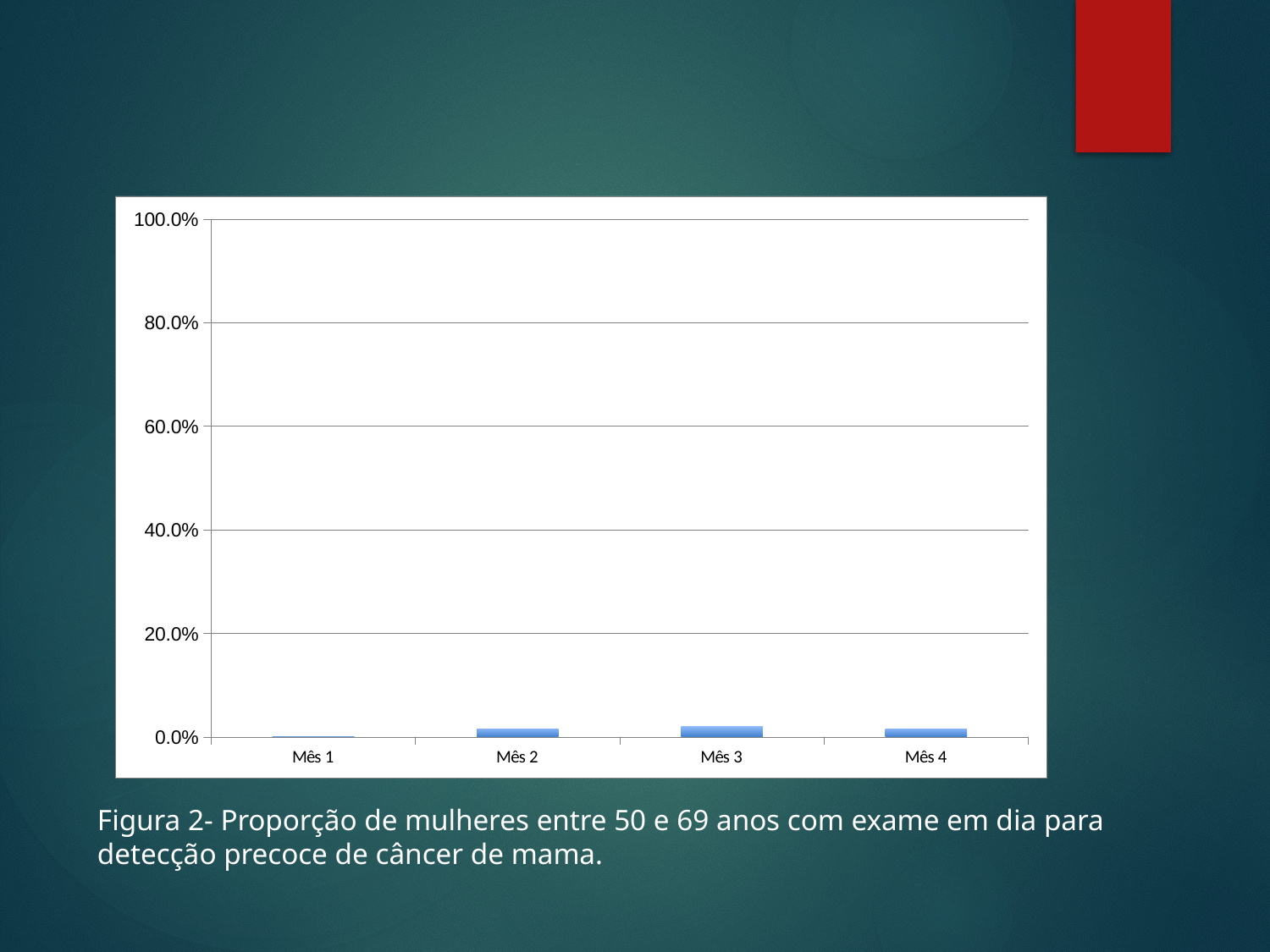
Which month has the highest bar in the chart? Mês 3 Is the value for Mês 2 greater or less than 20.0%? less Is the value for Mês 3 greater or less than 20.0%? less Which month has the lowest bar in the chart? Mês 1 Which is larger, the value for Mês 3 or the value for Mês 1? Mês 3 What is the figure caption below the chart? Figura 2- Proporção de mulheres entre 50 e 69 anos com exame em dia para detecção precoce de câncer de mama. What kind of chart is shown on the slide? bar chart How many categories are shown on the x axis of the chart? 4 Which is larger, the value for Mês 2 or the value for Mês 1? Mês 2 Is the value for Mês 4 greater or less than 40.0%? less What is the highest value shown on the y axis of the chart? 100.0%